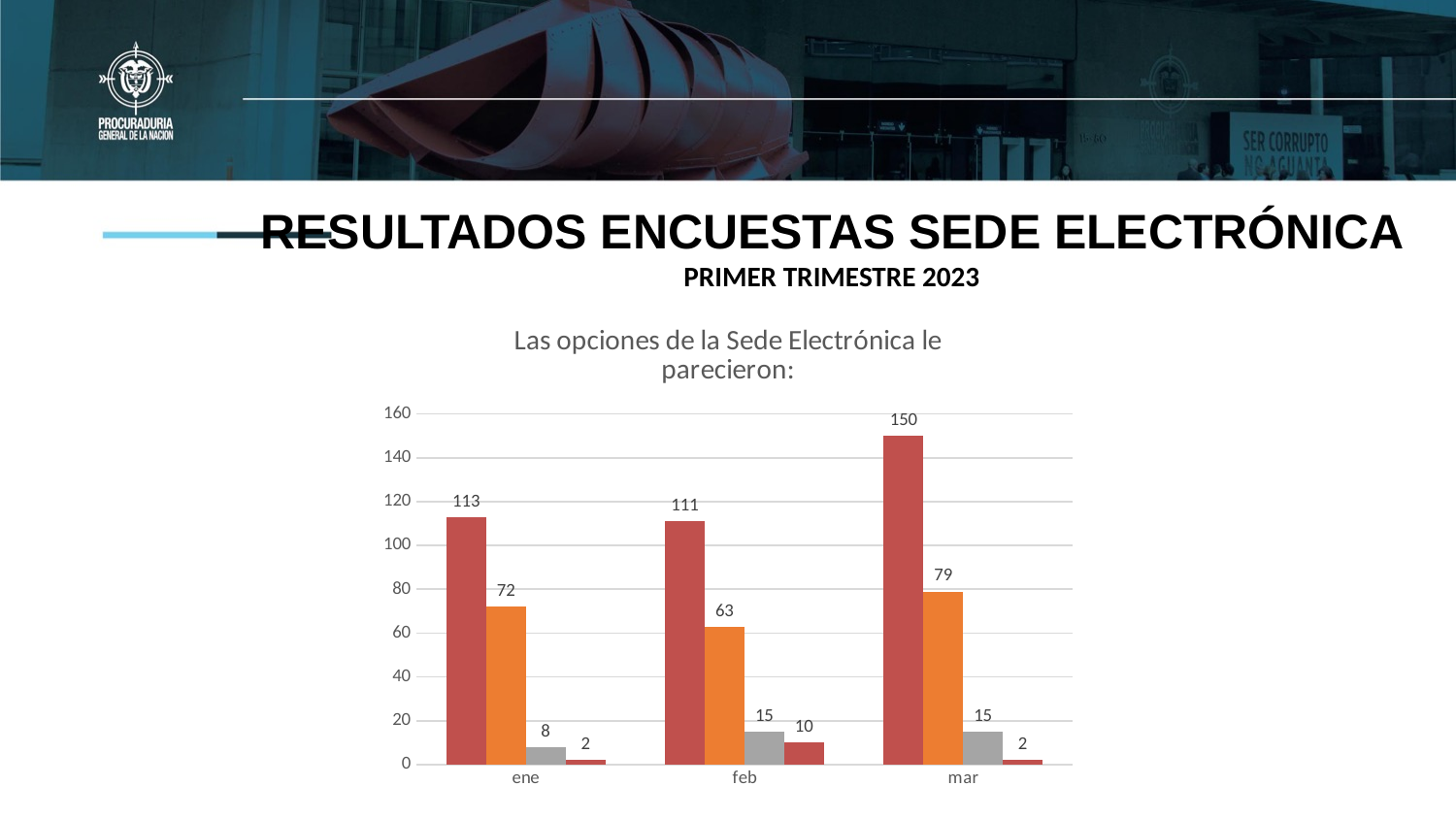
Which is larger: the orange bar for ene or the orange bar for mar? mar What is the value of the gray bar for ene? 8 What is the value of the smallest (rightmost) bar for feb? 10 In which month is the orange bar lowest? feb What is the difference between the dark red bar for mar and the dark red bar for ene? 37 What kind of chart is shown on the slide? bar chart In which month is the dark red bar highest? mar What is the title of the chart? Las opciones de la Sede Electrónica le parecieron: What is the value of the orange bar for feb? 63 How many months are shown on the x axis? 3 What is the value of the dark red bar for mar? 150 How many bars are plotted for each month? 4